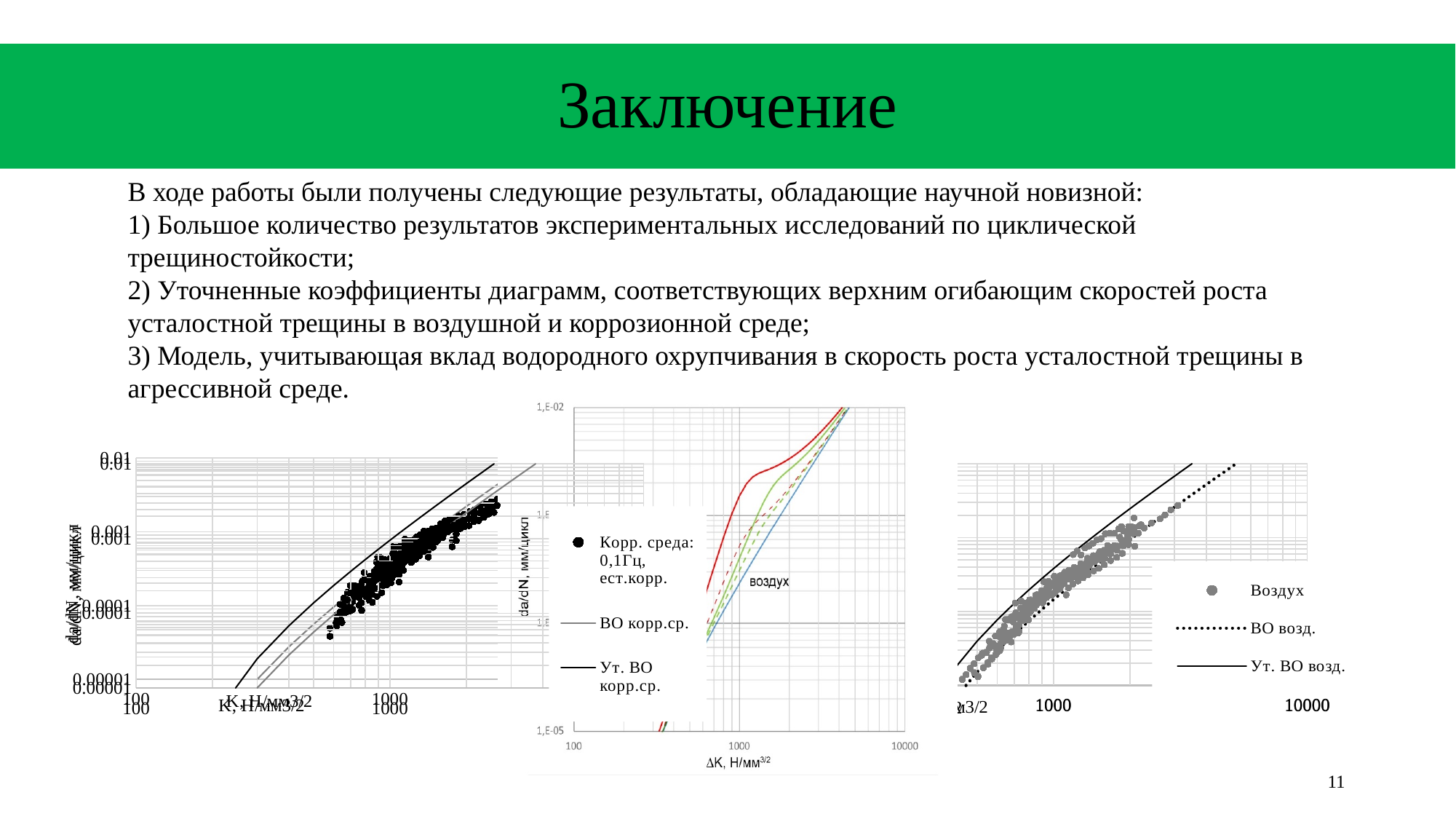
In the middle chart, what is the lowest value shown on the y axis? 1,E-05 In the right chart, do the plotted values rise or fall as the x-axis value increases? rise In the left chart, what is the label of the series drawn with black dots? Корр. среда: 0,1Гц, ест.корр. In the right chart, what is the label of the series drawn with gray dots? Воздух In the left chart, how many entries does the legend list? 3 In the left chart, do the plotted da/dN values rise or fall as ΔK increases along the x axis? rise What kind of chart is the middle chart? line chart In the left chart, what is the lowest value shown on the y axis? 0.00001 In the right chart, how many entries does the legend list? 3 In the middle chart, do the curves rise or fall as ΔK increases? rise What kind of chart is the left chart? scatter chart In the middle chart, what is the highest value shown on the y axis? 1,E-02